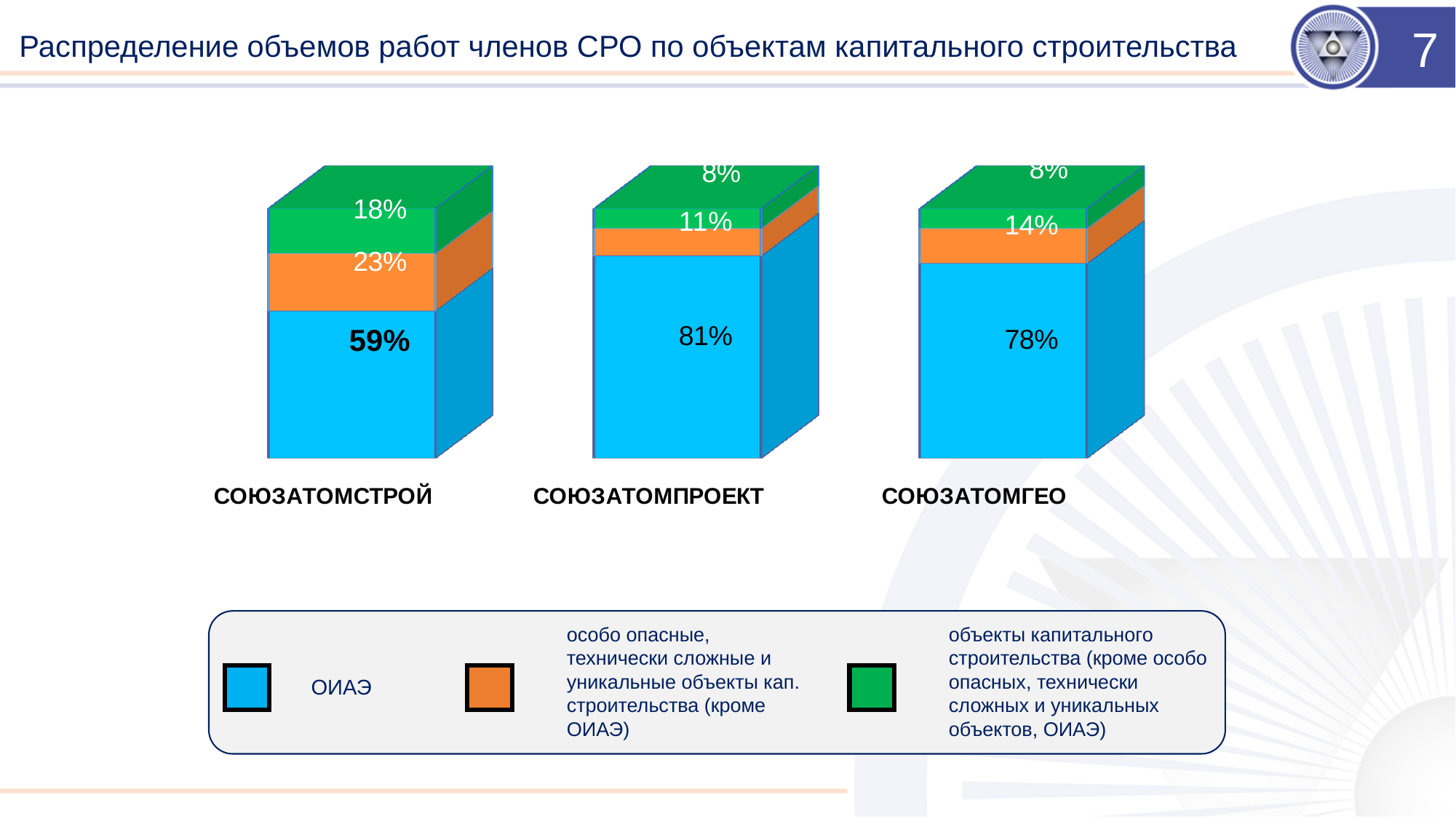
Which organisation has the lowest ОИАЭ share? СОЮЗАТОМСТРОЙ What is the ОИАЭ share for СОЮЗАТОМГЕО? 78% Which has a larger orange-segment share, СОЮЗАТОМСТРОЙ or СОЮЗАТОМГЕО? СОЮЗАТОМСТРОЙ What kind of chart is shown on the slide? Stacked bar chart How many series does the legend list? 3 What is the orange (особо опасные, технически сложные и уникальные объекты) share for СОЮЗАТОМСТРОЙ? 23% Which organisation has the highest ОИАЭ share? СОЮЗАТОМПРОЕКТ What is the green (объекты капитального строительства) share for СОЮЗАТОМГЕО? 8% How many organisations (bars) are shown in the chart? 3 What is the ОИАЭ share for СОЮЗАТОМСТРОЙ? 59% What is the ОИАЭ share for СОЮЗАТОМПРОЕКТ? 81% What is the difference between the ОИАЭ shares of СОЮЗАТОМПРОЕКТ and СОЮЗАТОМСТРОЙ? 22%